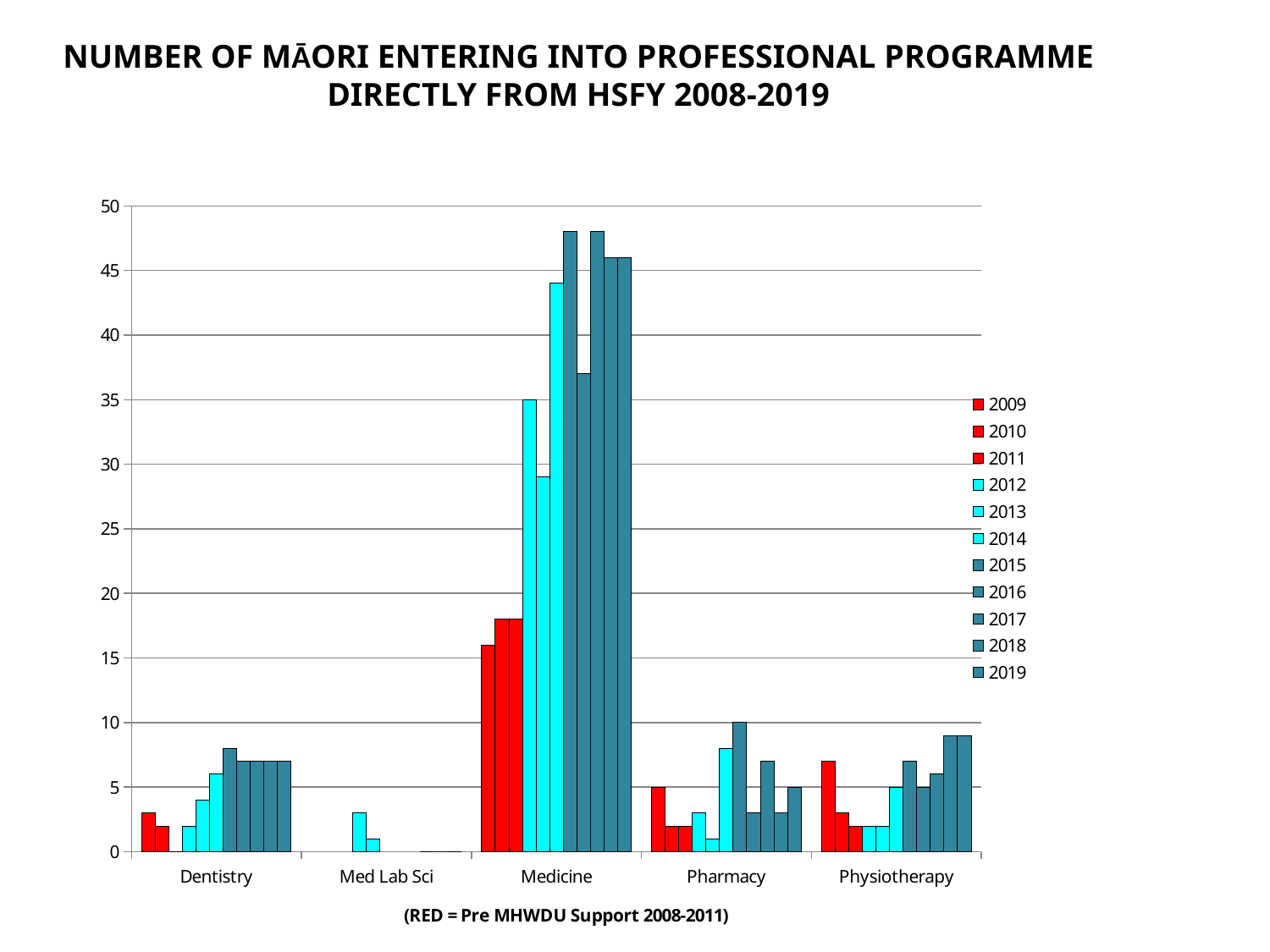
What kind of chart is shown on the slide? bar chart Which programme has the lowest numbers overall? Med Lab Sci Is the value for Medicine in 2018 greater or less than 40? greater How many series (years) does the legend list? 11 Is the value for Med Lab Sci in 2012 greater or less than 5? less Which programme has the highest bars overall? Medicine Which is larger, the value for Medicine in 2016 or the value for Physiotherapy in 2016? Medicine in 2016 What is the value for Pharmacy in 2015? 10 According to the note below the chart, what do the red bars represent? Pre MHWDU Support 2008-2011 Is the value for Medicine in 2015 greater or less than 45? greater How many programme categories are shown on the x axis? 5